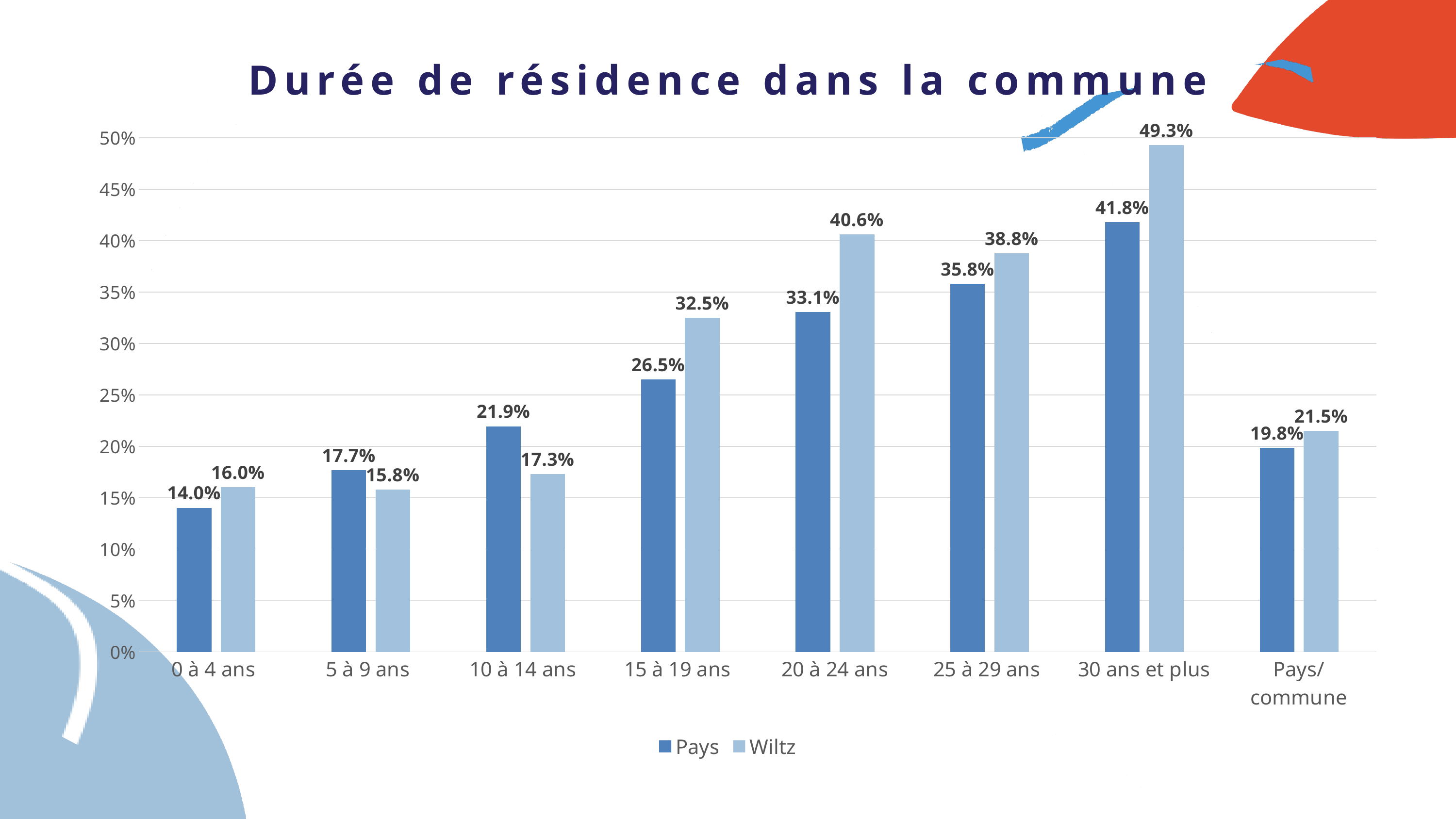
What is the Wiltz value for 30 ans et plus? 49.3% Which category has the lowest Wiltz value? 5 à 9 ans How many categories are shown on the x axis? 8 What kind of chart is shown on the slide? bar chart How many series does the legend list? 2 What is the difference between the Wiltz and Pays values for 20 à 24 ans? 7.5% What is the Wiltz value for 0 à 4 ans? 16.0% Is the Pays value for 25 à 29 ans greater or less than 30%? greater What is the Pays value for 15 à 19 ans? 26.5% Which is larger for 10 à 14 ans, the Pays value or the Wiltz value? Pays What is the title of the chart? Durée de résidence dans la commune Which category has the highest Pays value? 30 ans et plus